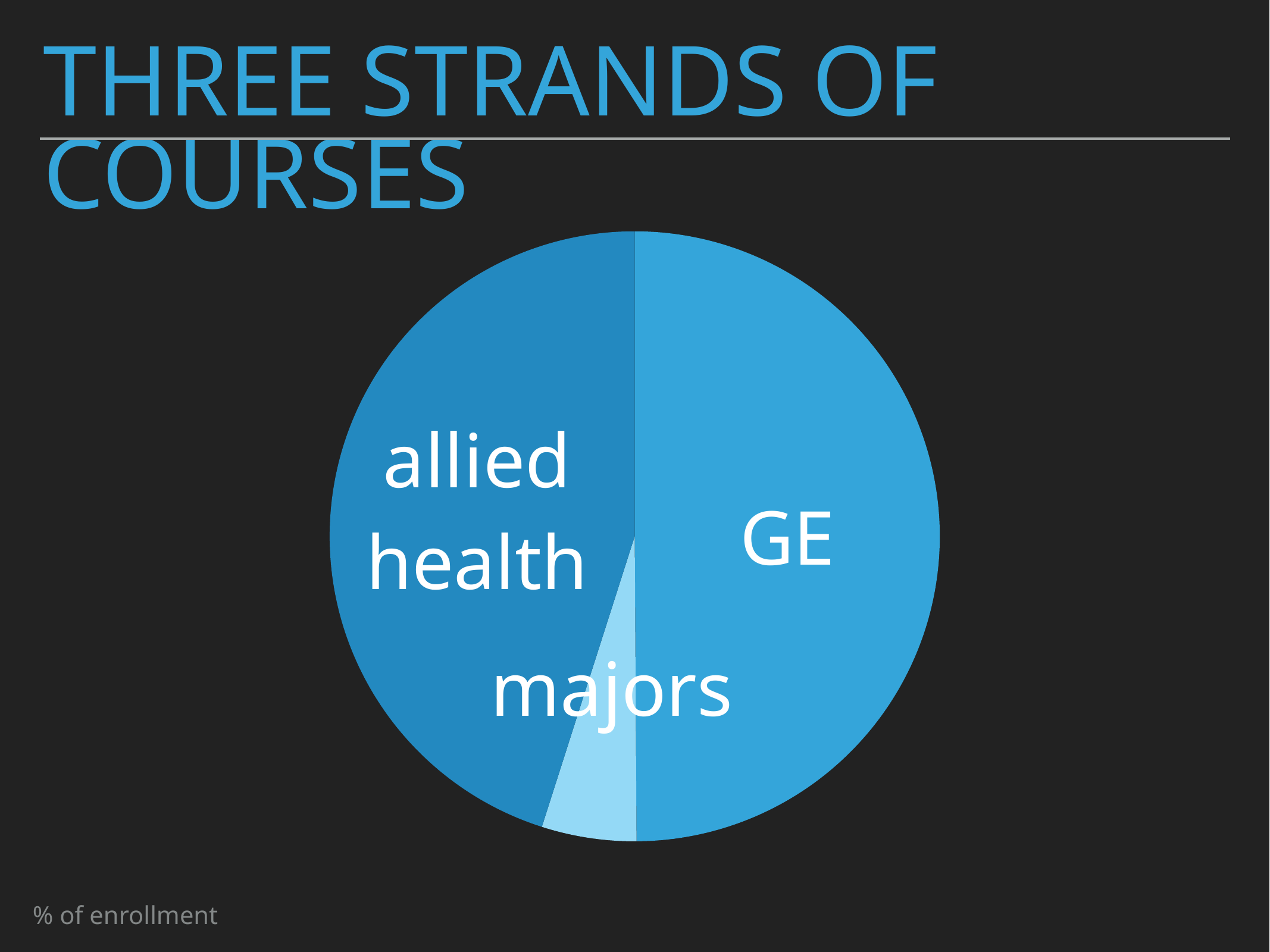
Which slice is larger, GE or majors? GE How many slices does the pie chart have? 3 Which slice of the pie chart is the largest? GE What kind of chart is shown on the slide? pie chart According to the note at the bottom of the slide, what does the pie chart show? % of enrollment Which slice is larger, allied health or majors? allied health What are the three categories labelled on the pie chart? allied health, majors, GE What is the title of the slide containing the pie chart? THREE STRANDS OF COURSES Which slice of the pie chart is the smallest? majors